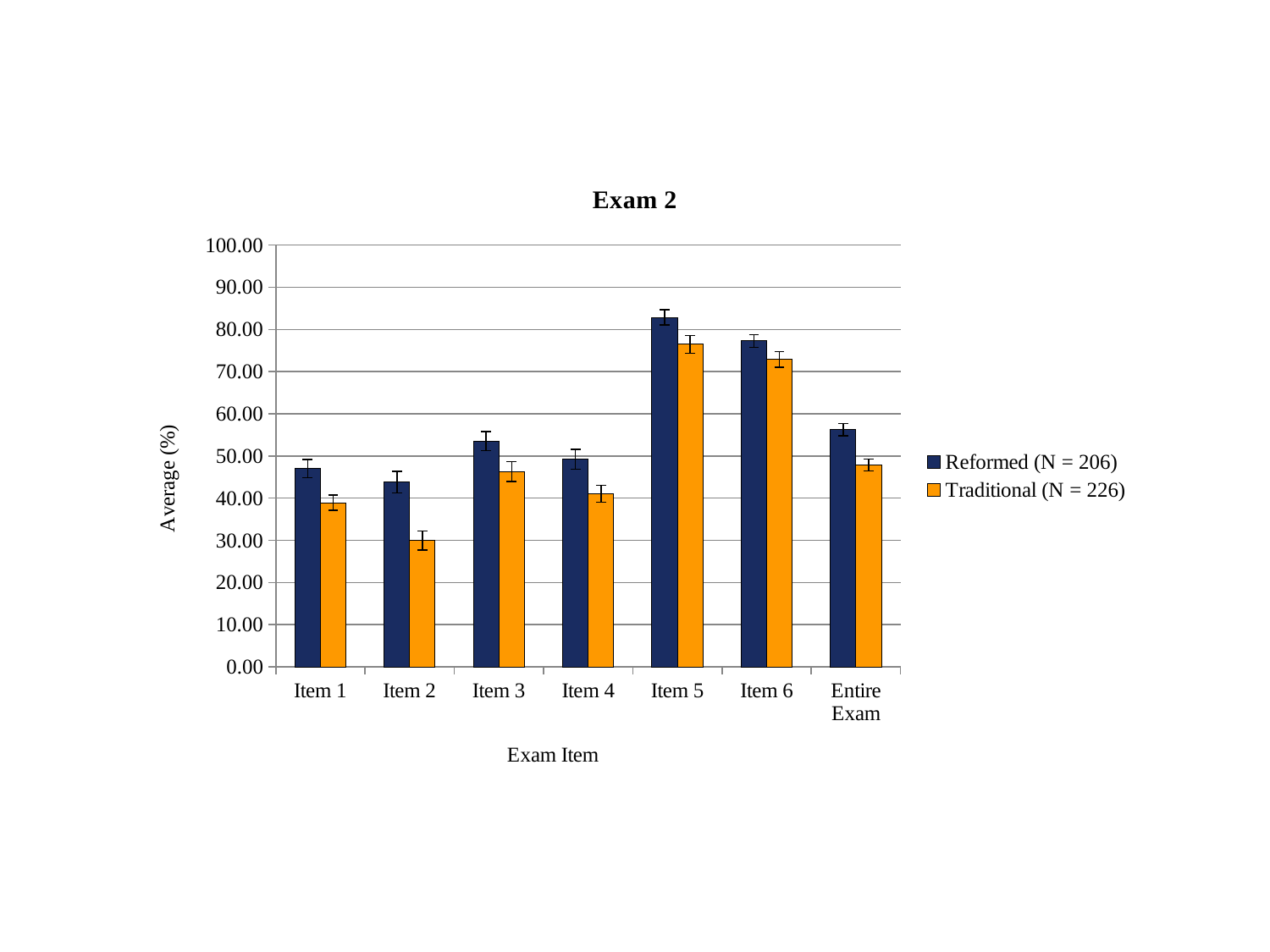
How many categories are shown on the x axis? 7 For the Traditional (N = 226) series, which exam item has the highest average? Item 5 What is the label on the y axis of the chart? Average (%) How many series does the legend list? 2 For the Traditional (N = 226) series, which exam item has the lowest average? Item 2 Is the Reformed (N = 206) value for Item 3 greater or less than 50.00? greater What is the title of the chart? Exam 2 For the Reformed (N = 206) series, which exam item has the highest average? Item 5 What kind of chart is shown on the slide? Bar chart Is the Traditional (N = 226) value for Item 2 greater or less than 40.00? less For Item 1, which series has the larger average, Reformed (N = 206) or Traditional (N = 226)? Reformed (N = 206) Is the Reformed (N = 206) value for Item 5 greater or less than 80.00? greater